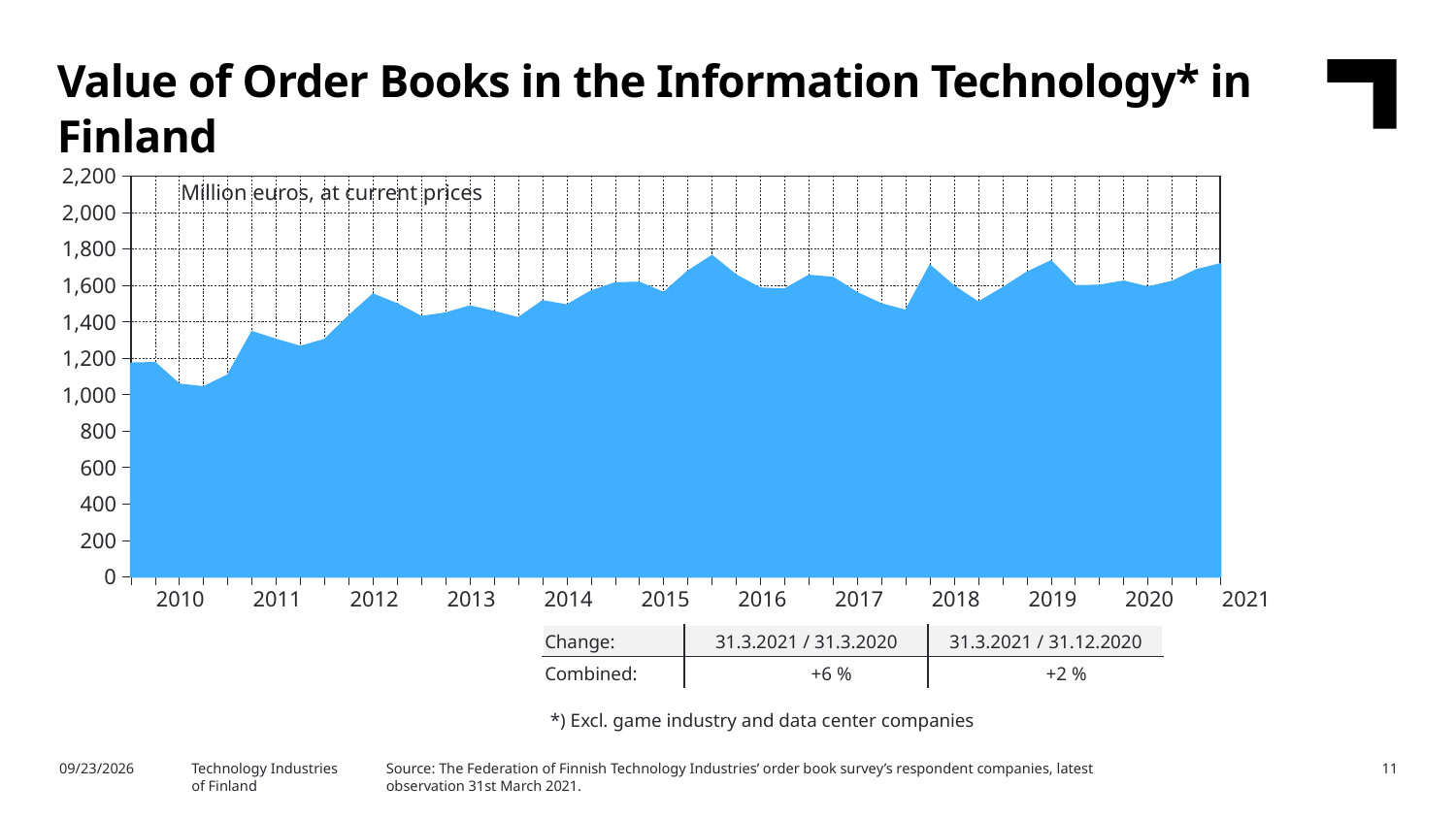
Is the value at the end of the series in 2021 greater or less than 1,600? greater Overall, do the values rise or fall from 2010 to 2021? rise In which year does the series reach its lowest value? 2010 Is the peak value in 2015 greater or less than 1,600? greater What is the highest value shown on the y axis? 2,200 Is the value at the start of 2010 greater or less than 1,000? greater How many year labels are shown along the x axis? 12 What kind of chart is shown on the slide? area chart What unit is stated in the label inside the chart area? Million euros, at current prices What is the title of the chart? Value of Order Books in the Information Technology* in Finland